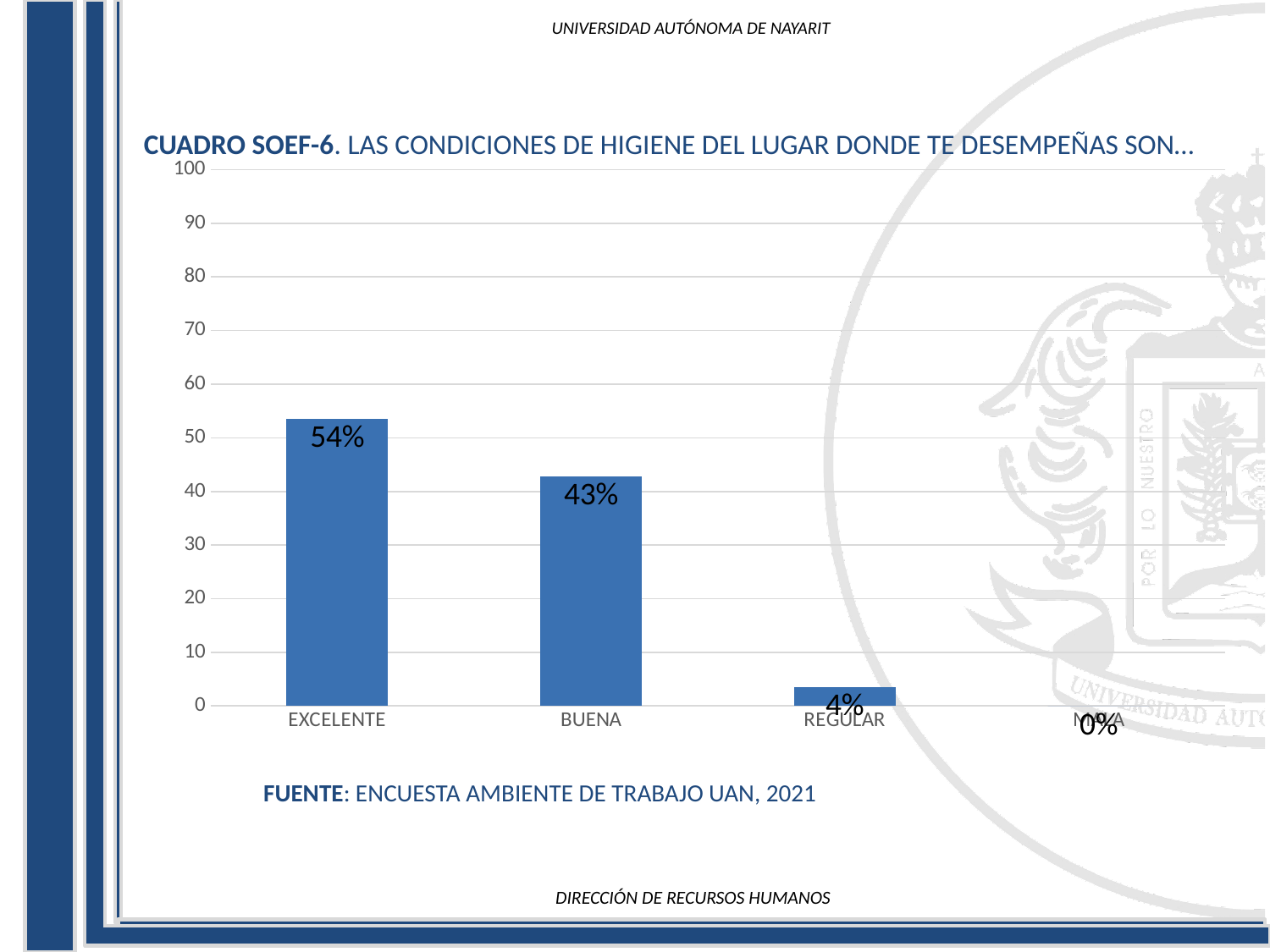
What is the value for REGULAR? 4% What is the value for EXCELENTE? 54% What is the source cited below the chart? ENCUESTA AMBIENTE DE TRABAJO UAN, 2021 What is the value for BUENA? 43% Which category has the highest value? EXCELENTE What type of chart is shown on the slide? bar chart Which is larger, the value for BUENA or the value for REGULAR? BUENA Is the value for EXCELENTE greater or less than 50? greater What is the difference between the values for EXCELENTE and BUENA? 11% What is the difference between the values for BUENA and REGULAR? 39% Is the value for BUENA greater or less than 50? less How many categories are shown on the x axis? 4